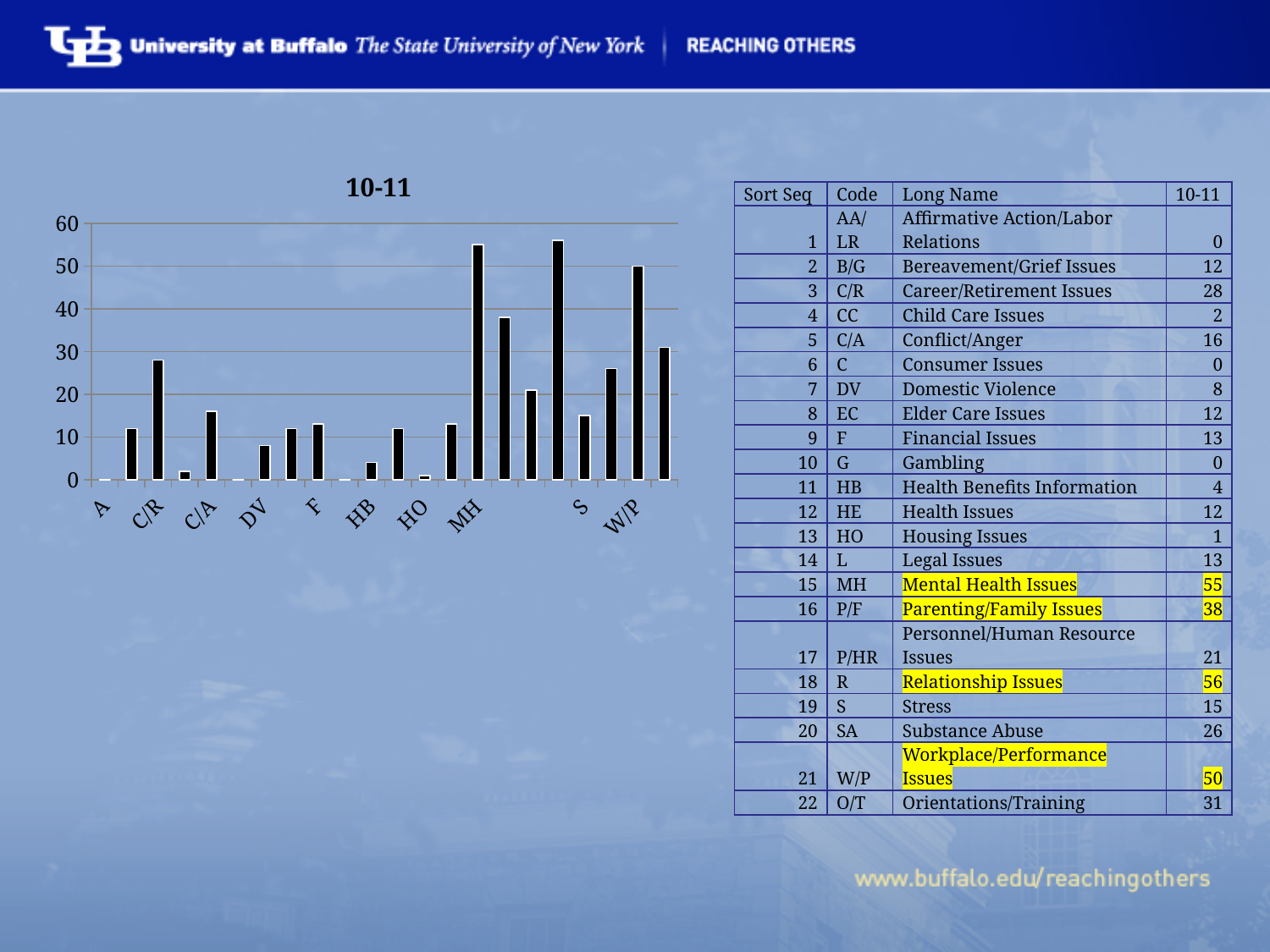
Is the value for HB in the chart greater or less than 10? less What is the title of the chart? 10-11 What kind of chart is shown on the slide? bar chart Is the value for C/R in the chart greater or less than 20? greater According to the table on the slide, what is the 10-11 value for MH (Mental Health Issues)? 55 Which has the taller bar in the chart, C/R or C/A? C/R Is the value for W/P in the chart greater or less than 40? greater Which has the taller bar in the chart, MH or S? MH According to the table on the slide, what is the 10-11 value for W/P (Workplace/Performance Issues)? 50 How many bars are plotted in the chart? 19